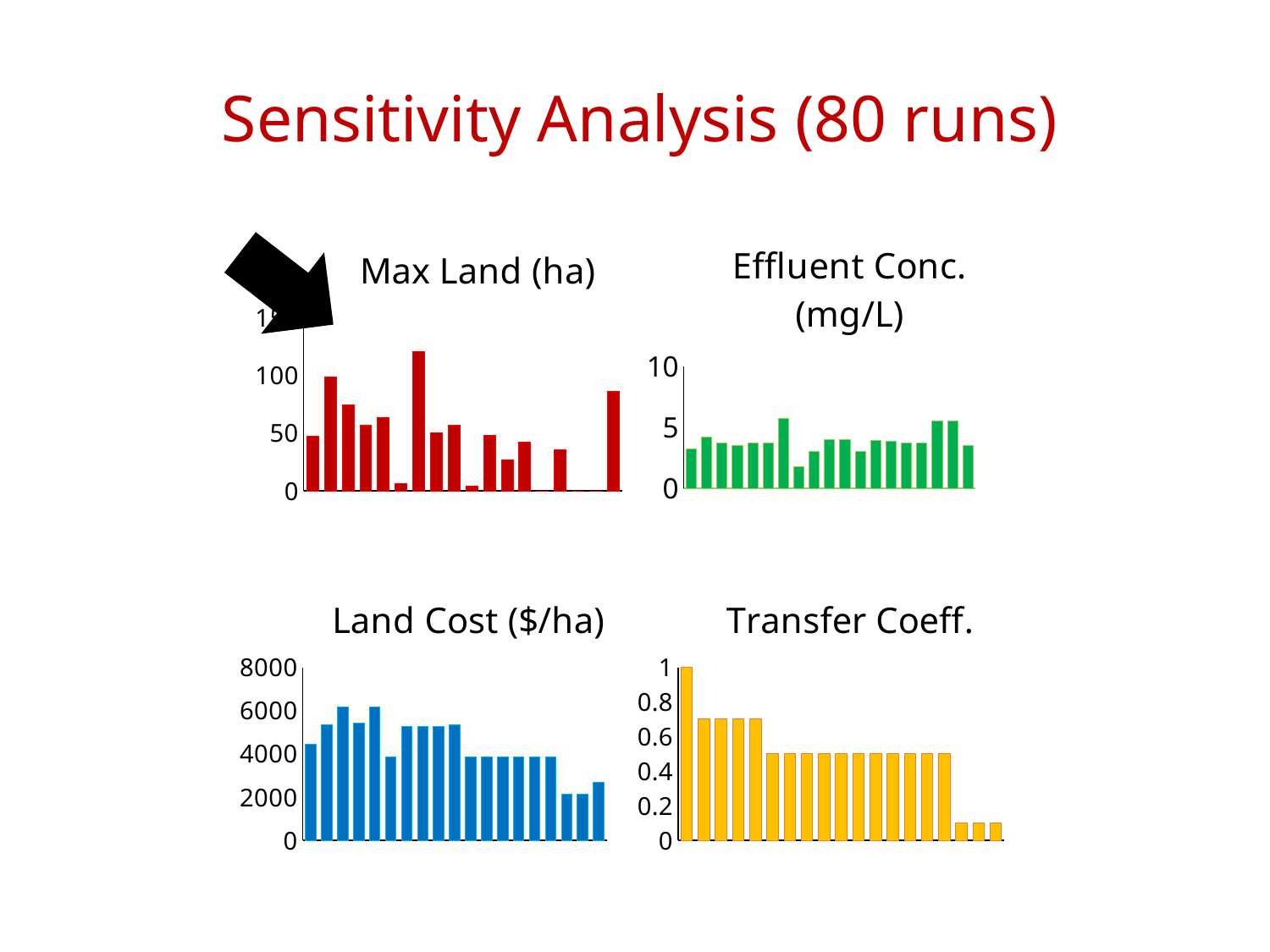
In the Transfer Coeff. chart, what is the value of the first bar? 1 What is the title of the chart in the top-right of the slide? Effluent Conc. (mg/L) In the Transfer Coeff. chart, which bar is the highest: the first bar or the last bar? the first bar What kind of chart is the Max Land (ha) chart? bar chart In the Transfer Coeff. chart, do the values generally rise or fall from left to right? fall In the Land Cost ($/ha) chart, is the first bar greater or less than 2000? greater How many charts are shown on the slide? 4 In the Land Cost ($/ha) chart, is the shortest bar greater or less than 4000? less In the Max Land (ha) chart, is the tallest bar greater or less than 100? greater What is the title of the chart in the bottom-left of the slide? Land Cost ($/ha)